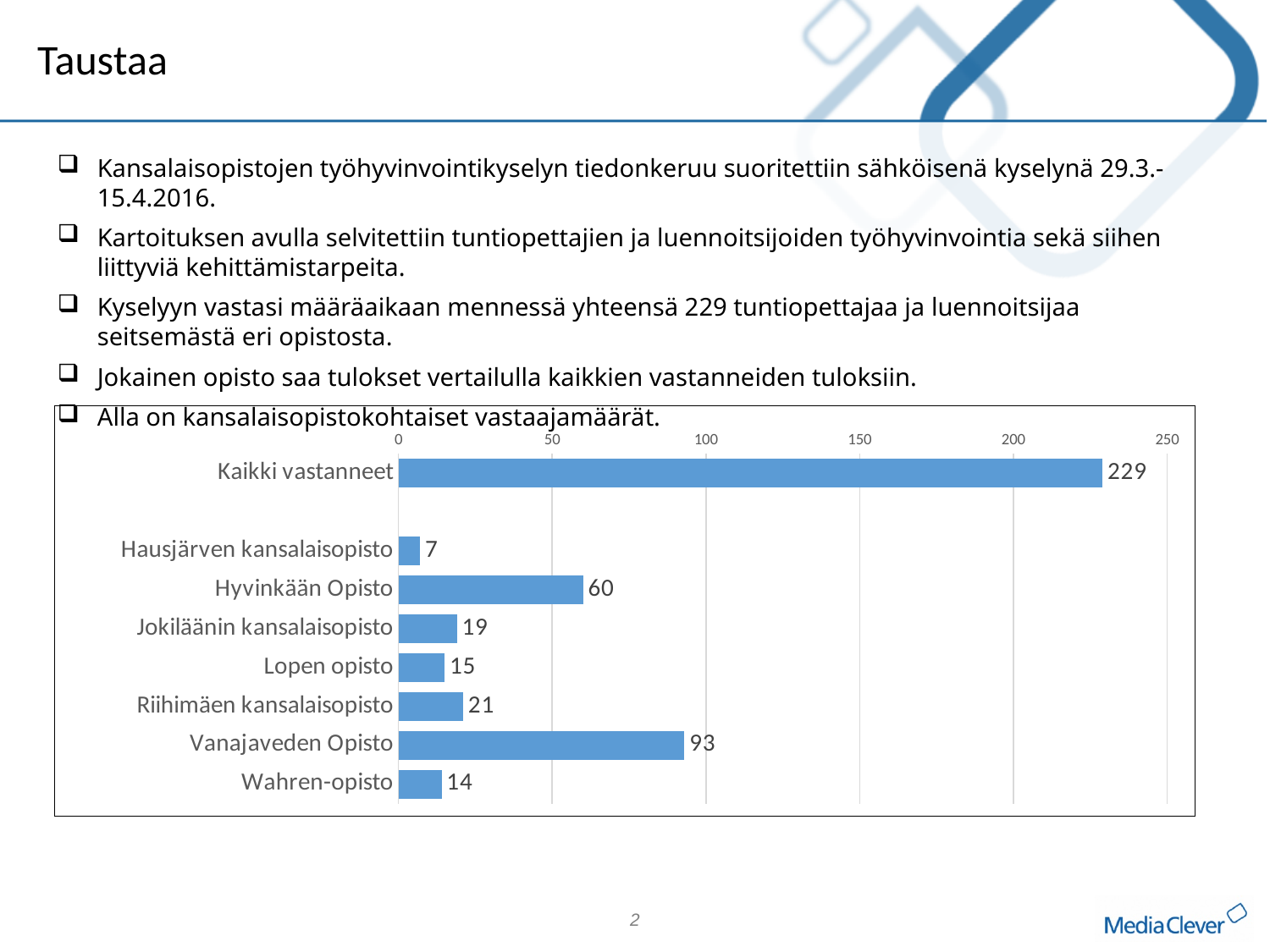
Which is larger, the value for Riihimäen kansalaisopisto or Jokiläänin kansalaisopisto? Riihimäen kansalaisopisto What kind of chart is shown on the slide? bar chart Which individual opisto (excluding Kaikki vastanneet) has the highest value? Vanajaveden Opisto What is the value for Vanajaveden Opisto? 93 What is the value for Kaikki vastanneet? 229 Is the value for Hyvinkään Opisto greater or less than 50? greater What is the difference between the values for Lopen opisto and Hausjärven kansalaisopisto? 8 Which category has the lowest value? Hausjärven kansalaisopisto What is the value for Hyvinkään Opisto? 60 What is the value for Wahren-opisto? 14 What is the difference between the values for Vanajaveden Opisto and Hyvinkään Opisto? 33 How many categories are shown in the chart? 8